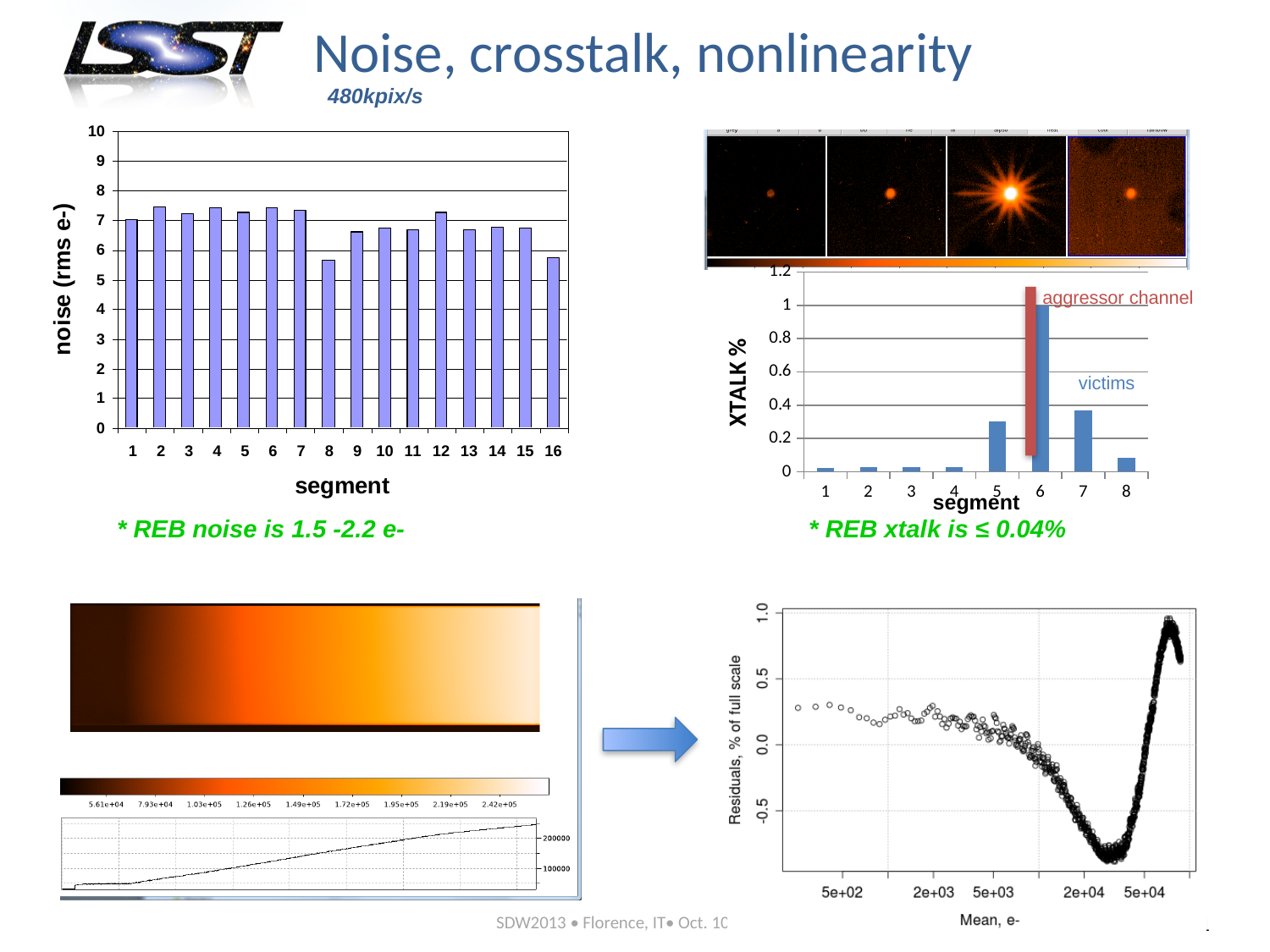
On the noise chart (top left), what is the label of the y axis? noise (rms e-) On the XTALK % chart (top right), which has the higher value, segment 6 or segment 7? segment 6 On the noise chart (top left), how many segments are shown on the x axis? 16 On the XTALK % chart (top right), which segment has the highest crosstalk? 6 What kind of chart is the XTALK % chart (top right)? bar chart On the noise chart (top left), is the value for segment 2 greater or less than 7? greater On the XTALK % chart (top right), how many segments are shown on the x axis? 8 On the noise chart (top left), is the value for segment 8 greater or less than 6? less On the noise chart (top left), which has the higher noise, segment 2 or segment 8? segment 2 On the noise chart (top left), is the value for segment 9 greater or less than 7? less